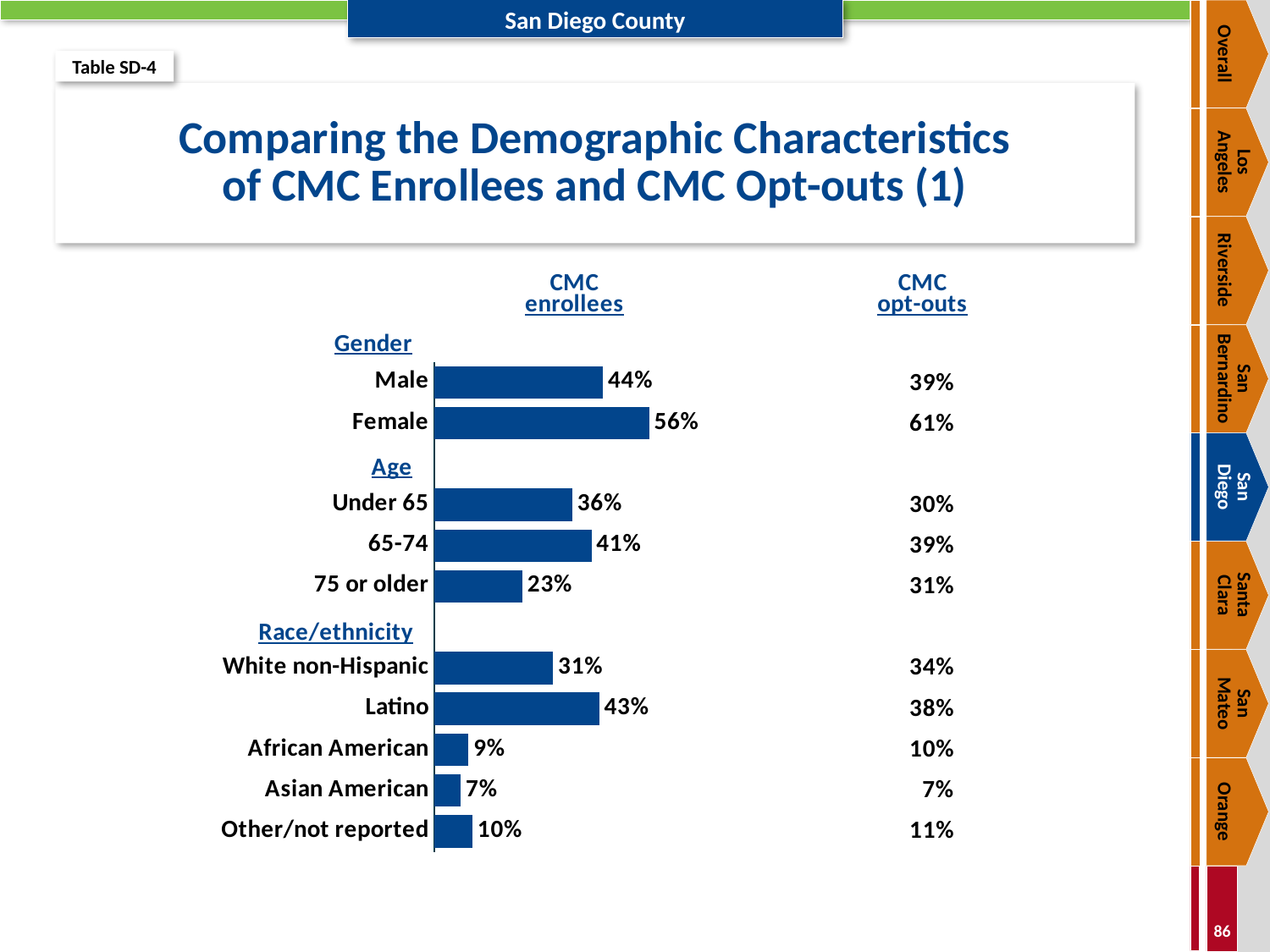
What percentage of CMC enrollees are Latino? 43% What percentage of CMC enrollees are Female according to the bar chart? 56% What is the difference between the Female and Male percentages for CMC enrollees? 12 percentage points What are the two column headings above the data on the slide? CMC enrollees and CMC opt-outs Which category has the longest bar in the CMC enrollees chart? Female What percentage of CMC opt-outs are Female, as shown in the right-hand column? 61% Which category has the shortest bar in the CMC enrollees chart? Asian American What is the difference between the Under 65 and 75 or older percentages for CMC enrollees? 13 percentage points What type of chart is used to show the CMC enrollees percentages? Bar chart Among CMC enrollees, which is larger: the Latino share or the White non-Hispanic share? Latino What percentage of CMC enrollees are 75 or older? 23% How many bars are plotted in the CMC enrollees chart? 10